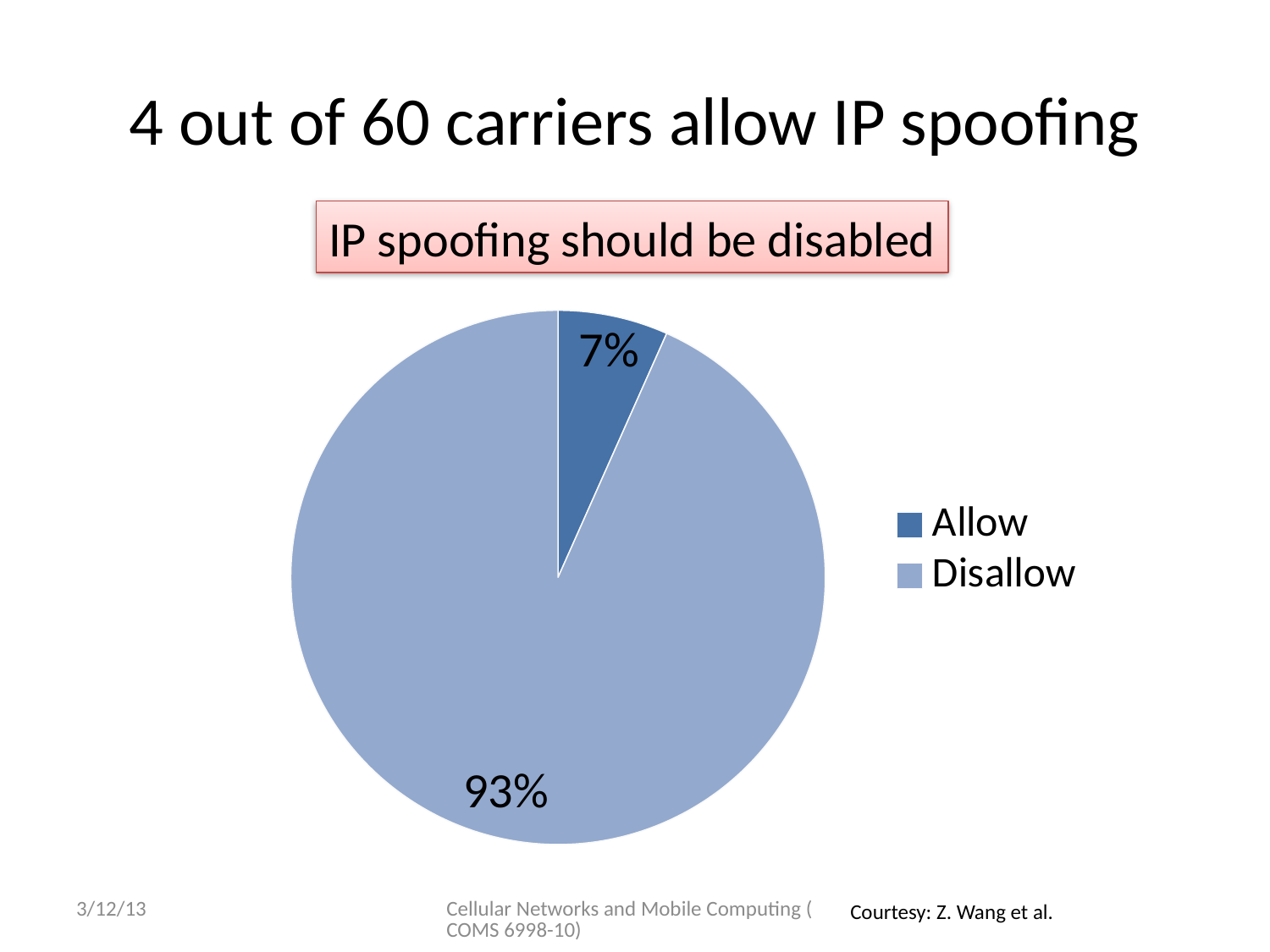
What kind of chart is shown on the slide? pie chart How many slices does the pie chart have? 2 How many entries does the legend list? 2 Which legend entry is shown in the darker blue colour? Allow What is the total of the two slice percentages shown on the pie? 100% Which slice of the pie is the smallest? Allow What share of the pie does the Allow slice represent? 7% What is the difference in percentage points between the Disallow and Allow slices? 86% What share of the pie does the Disallow slice represent? 93% Which slice of the pie is the largest? Disallow Which is larger, the Allow slice or the Disallow slice? Disallow What is the title of the slide containing the pie chart? 4 out of 60 carriers allow IP spoofing